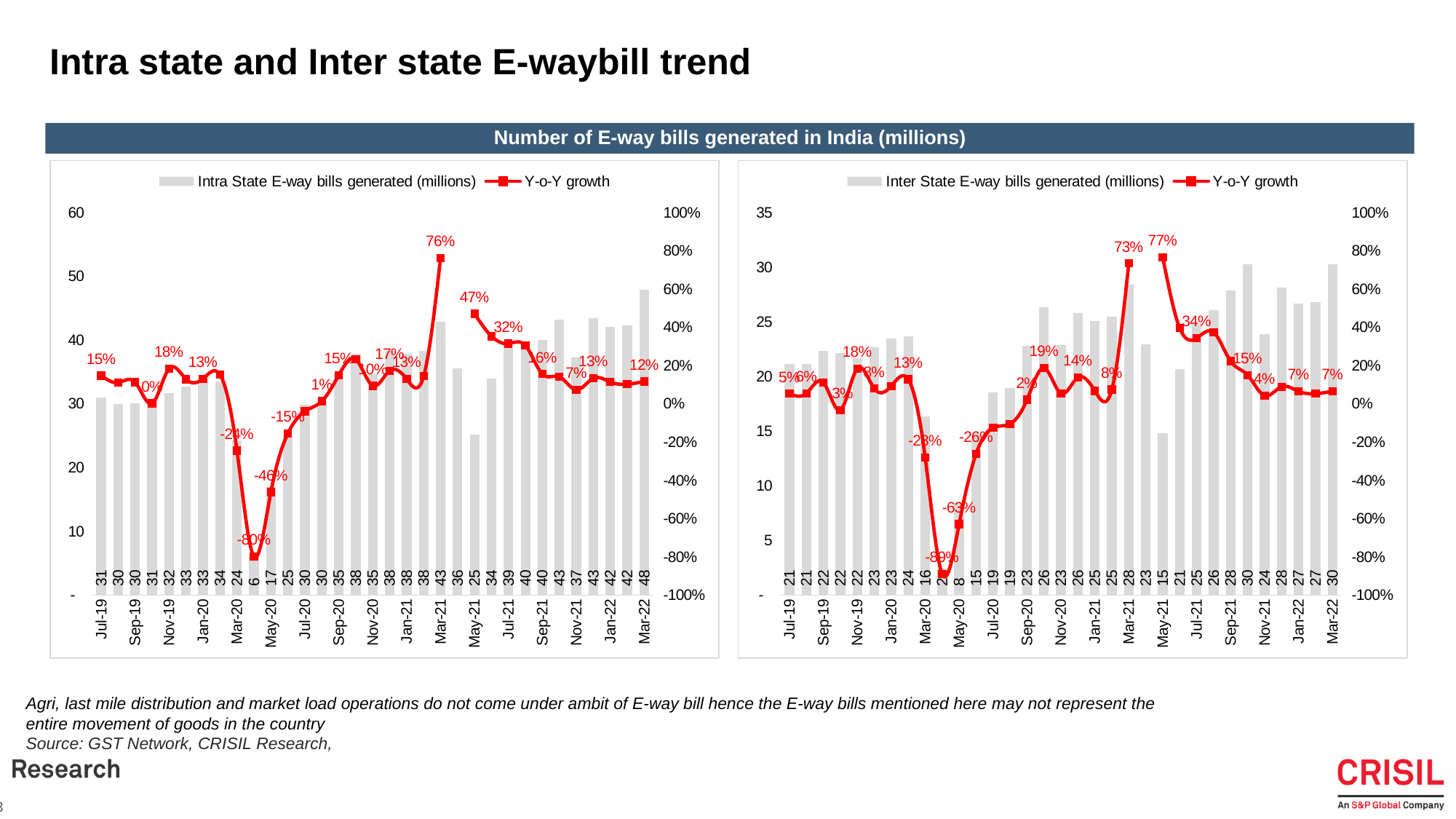
In the left chart, Intra State E-way bills generated, what is the value of the bar for Mar-22? 48 In the right chart, Inter State E-way bills generated, what is the lowest bar value shown? 2 What is the title shown in the banner above the two charts? Number of E-way bills generated in India (millions) In the left chart, Intra State E-way bills generated, which month has the highest bar? Mar-22 In the left chart, Intra State E-way bills generated, does the Y-o-Y growth line rise or fall from Mar-21 to Mar-22? Fall In the left chart, Intra State E-way bills generated, what is the difference between the Mar-22 bar and the Jul-19 bar? 17 What kind of chart is the left chart, Intra State E-way bills generated? A bar chart combined with a line chart In the left chart, Intra State E-way bills generated, what is the Y-o-Y growth shown for Mar-21? 76% In the right chart, Inter State E-way bills generated, what is the value of the bar for Mar-22? 30 In the right chart, Inter State E-way bills generated, which is larger: the bar for Mar-22 or the bar for Jul-19? Mar-22 How many series does the legend of the right chart, Inter State E-way bills generated, list? 2 In the right chart, Inter State E-way bills generated, what is the Y-o-Y growth shown for May-21? 77%